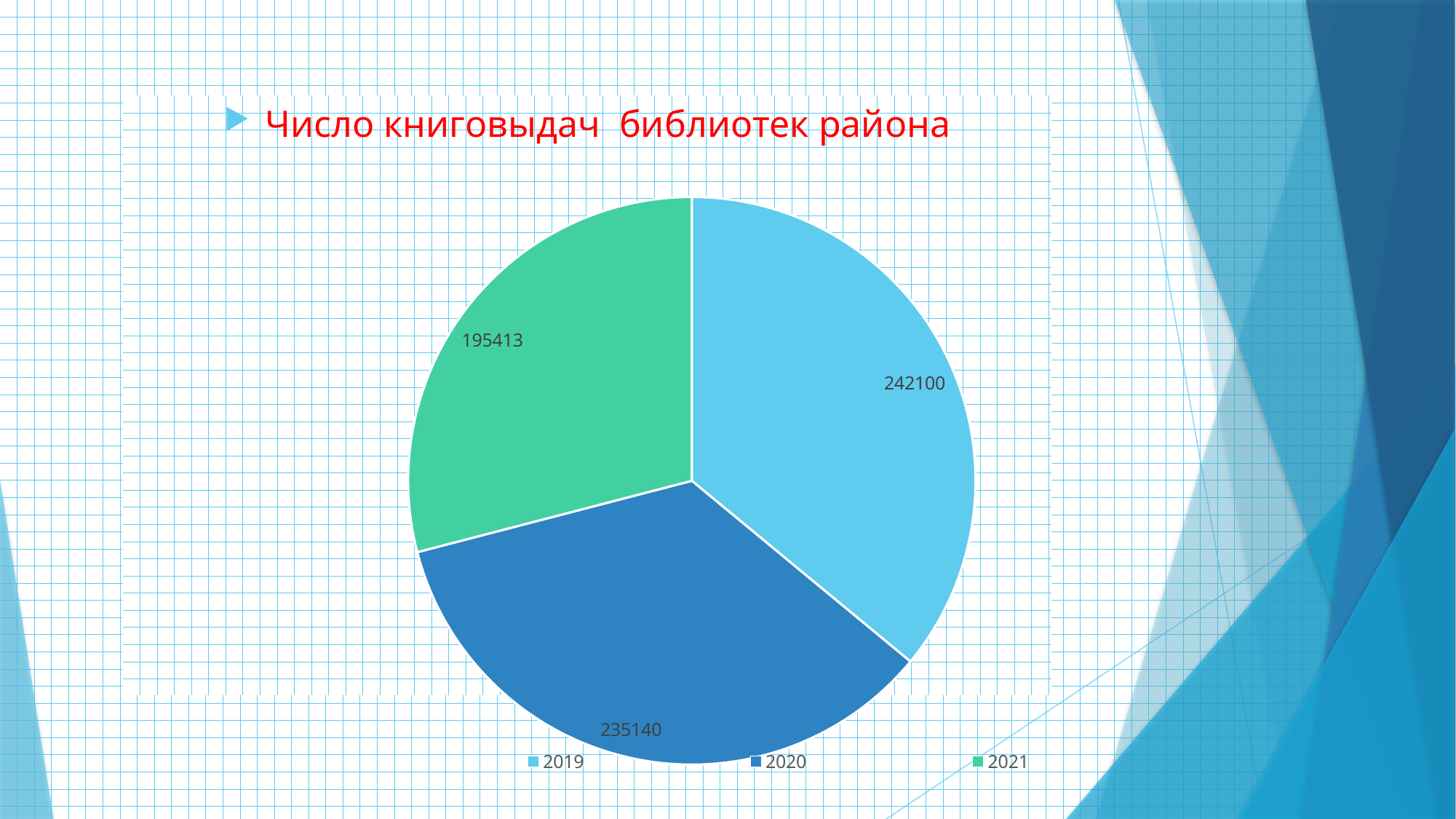
Which year has the smallest slice in the pie chart? 2021 How many slices does the pie chart have? 3 Which is larger, the value for 2020 or the value for 2021? 2020 Which year has the largest slice in the pie chart? 2019 What is the value for 2021 in the pie chart? 195413 What kind of chart is shown on the slide? pie chart What is the difference between the values for 2020 and 2021? 39727 What is the title of the chart on the slide? Число книговыдач библиотек района What is the value for 2019 in the pie chart? 242100 What is the difference between the values for 2019 and 2020? 6960 How many entries does the legend list? 3 What is the value for 2020 in the pie chart? 235140